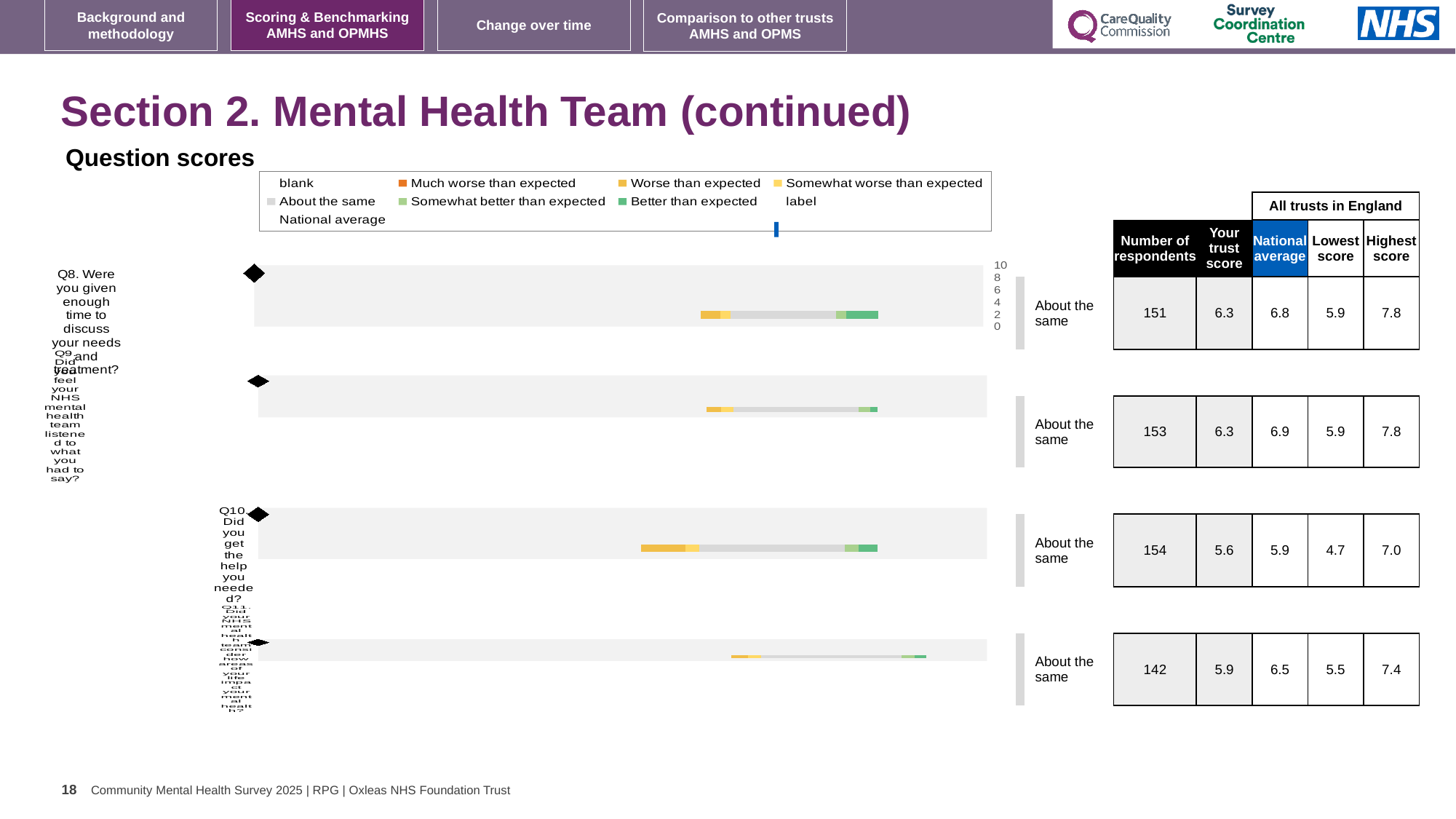
What is the difference between the national average and the trust score for Q11? 0.6 What benchmark category is shown next to each of the four question charts? About the same What is the lowest score across all trusts in England for Q9? 5.9 What is the 'Your trust score' for Q8 (Were you given enough time to discuss your needs and treatment?)? 6.3 What colour does the legend use for 'Much worse than expected'? orange Which is larger: the highest score for Q8 or the highest score for Q10? Q8 What is the national average for Q10 (Did you get the help you needed?)? 5.9 How many questions (Q8 to Q11) are plotted in the question scores charts? 4 Which question has the lowest 'Your trust score'? Q10 What is the difference between the highest and lowest scores for Q10? 2.3 What kind of chart is used to show the question scores on this slide? bar chart How many respondents answered Q11? 142